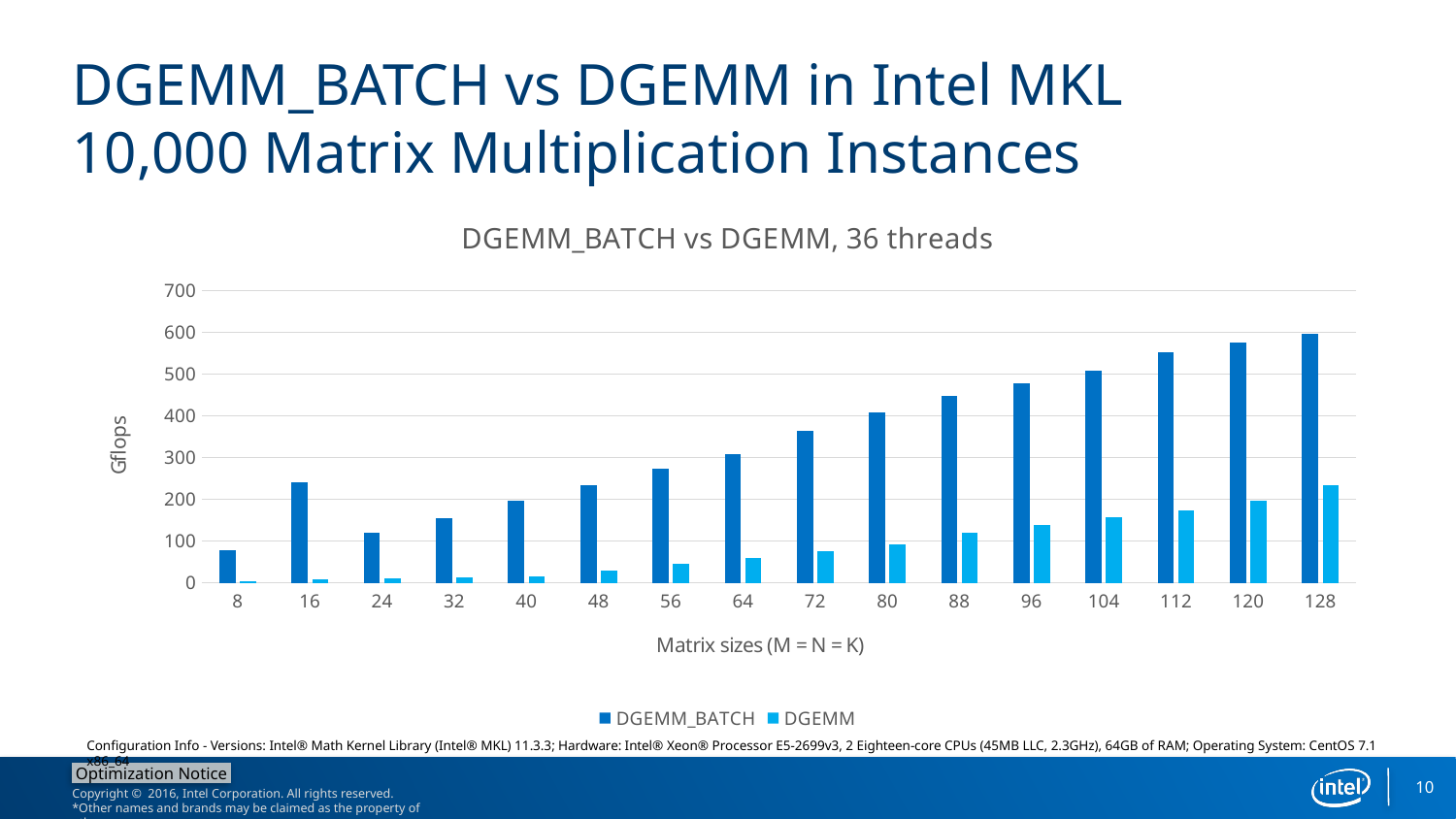
What is the title of the chart? DGEMM_BATCH vs DGEMM, 36 threads How many series does the legend list? 2 Do the DGEMM_BATCH values rise or fall as the matrix size increases? rise What type of chart is shown on the slide? bar chart Is the DGEMM value for matrix size 128 greater or less than 200? greater Which matrix size has the highest DGEMM_BATCH value? 128 How many matrix sizes are shown on the x axis? 16 Is the DGEMM_BATCH value for matrix size 96 greater or less than 500? less Is the DGEMM value for matrix size 8 greater or less than 100? less Which matrix size has the lowest DGEMM value? 8 At matrix size 64, which series has the larger value, DGEMM_BATCH or DGEMM? DGEMM_BATCH